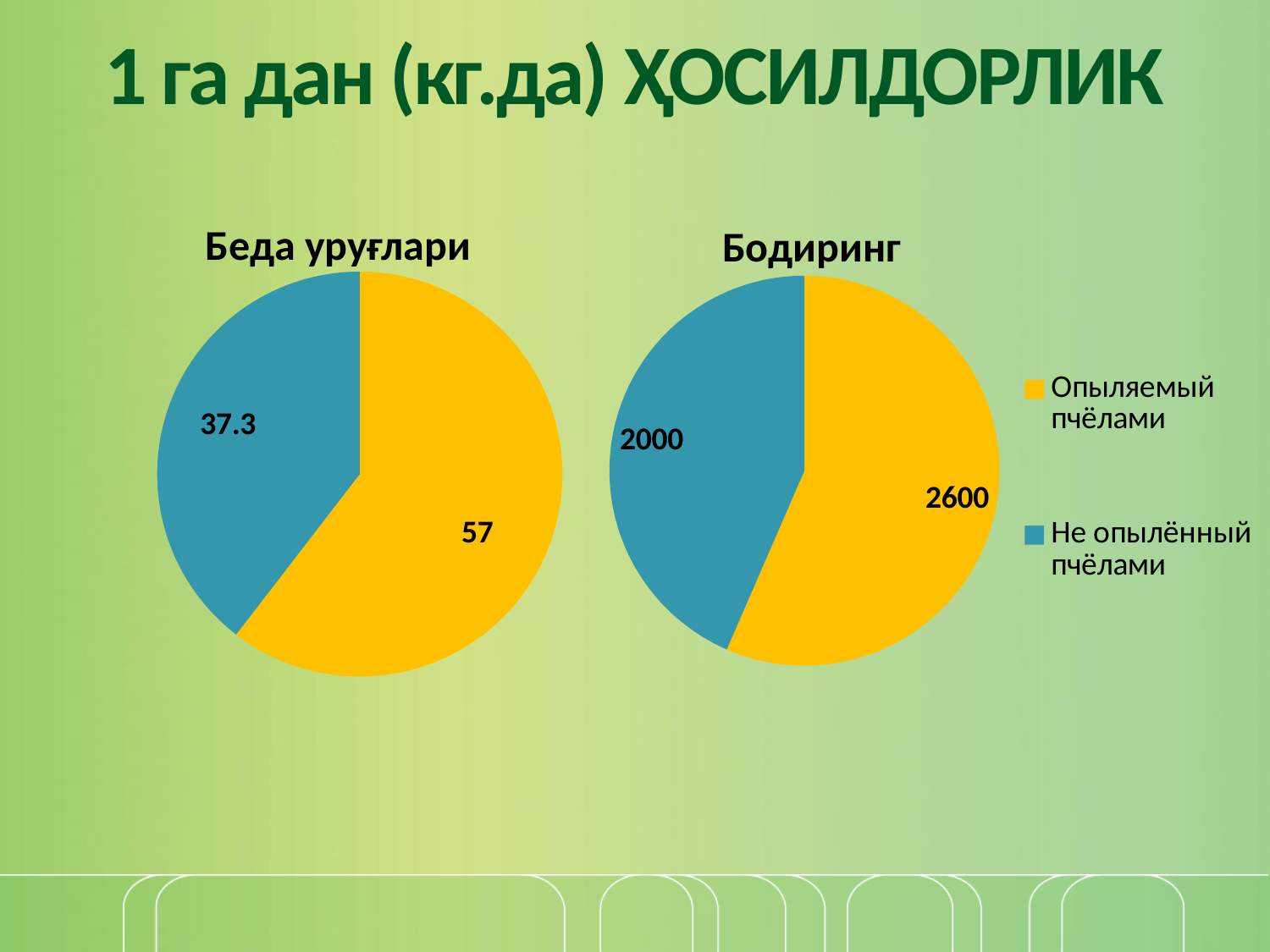
How many slices does the 'Бодиринг' pie chart have? 2 In the 'Бодиринг' pie chart, which is larger: 'Опыляемый пчёлами' or 'Не опылённый пчёлами'? Опыляемый пчёлами In the 'Бодиринг' pie chart, which category has the smallest slice? Не опылённый пчёлами In the 'Бодиринг' pie chart, what is the value for 'Не опылённый пчёлами'? 2000 In the 'Беда уруғлари' pie chart, what is the difference between the 'Опыляемый пчёлами' and 'Не опылённый пчёлами' values? 19.7 What type of chart is used for 'Беда уруғлари' and 'Бодиринг'? Pie chart In the 'Бодиринг' pie chart, what is the difference between the 'Опыляемый пчёлами' and 'Не опылённый пчёлами' values? 600 In the 'Беда уруғлари' pie chart, what is the value for 'Не опылённый пчёлами'? 37.3 In the 'Беда уруғлари' pie chart, what is the value for 'Опыляемый пчёлами'? 57 What is the title of the slide? 1 га дан (кг.да) ҲОСИЛДОРЛИК In the 'Бодиринг' pie chart, what is the value for 'Опыляемый пчёлами'? 2600 In the 'Беда уруғлари' pie chart, which category has the largest slice? Опыляемый пчёлами